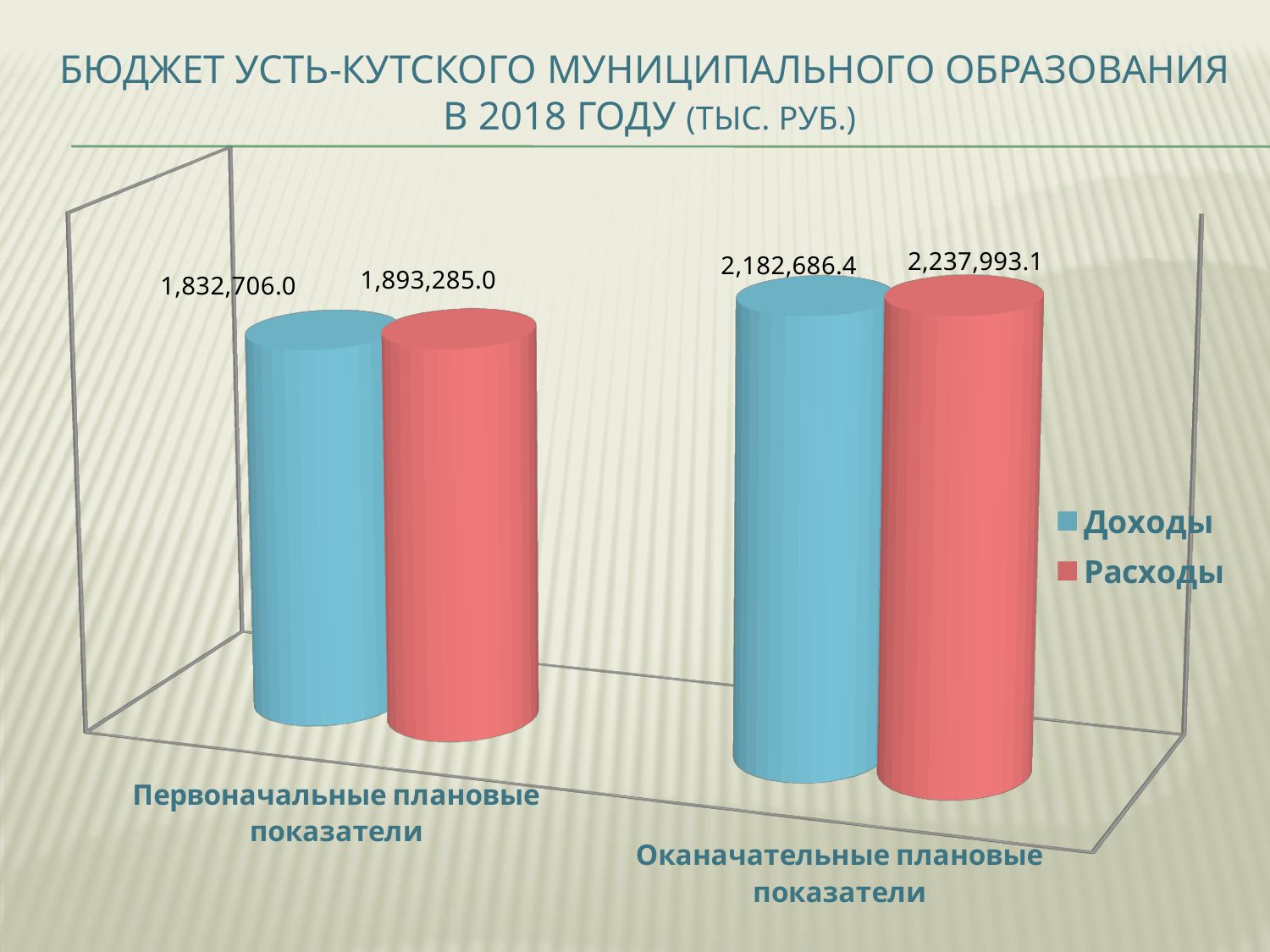
What is the difference between Расходы and Доходы for Оканачательные плановые показатели? 55,306.7 Which bar has the highest value on the chart? Расходы, Оканачательные плановые показатели How many series does the legend list? 2 What type of chart is shown on the slide? Bar chart Which is larger: Доходы for Оканачательные плановые показатели or Расходы for Первоначальные плановые показатели? Доходы for Оканачательные плановые показатели What is the value of Расходы for Оканачательные плановые показатели? 2,237,993.1 What is the value of Расходы for Первоначальные плановые показатели? 1,893,285.0 What is the value of Доходы for Первоначальные плановые показатели? 1,832,706.0 What is the value of Доходы for Оканачательные плановые показатели? 2,182,686.4 What is the difference between Расходы and Доходы for Первоначальные плановые показатели? 60,579.0 Which bar has the lowest value on the chart? Доходы, Первоначальные плановые показатели By how much did Доходы increase from Первоначальные плановые показатели to Оканачательные плановые показатели? 349,980.4